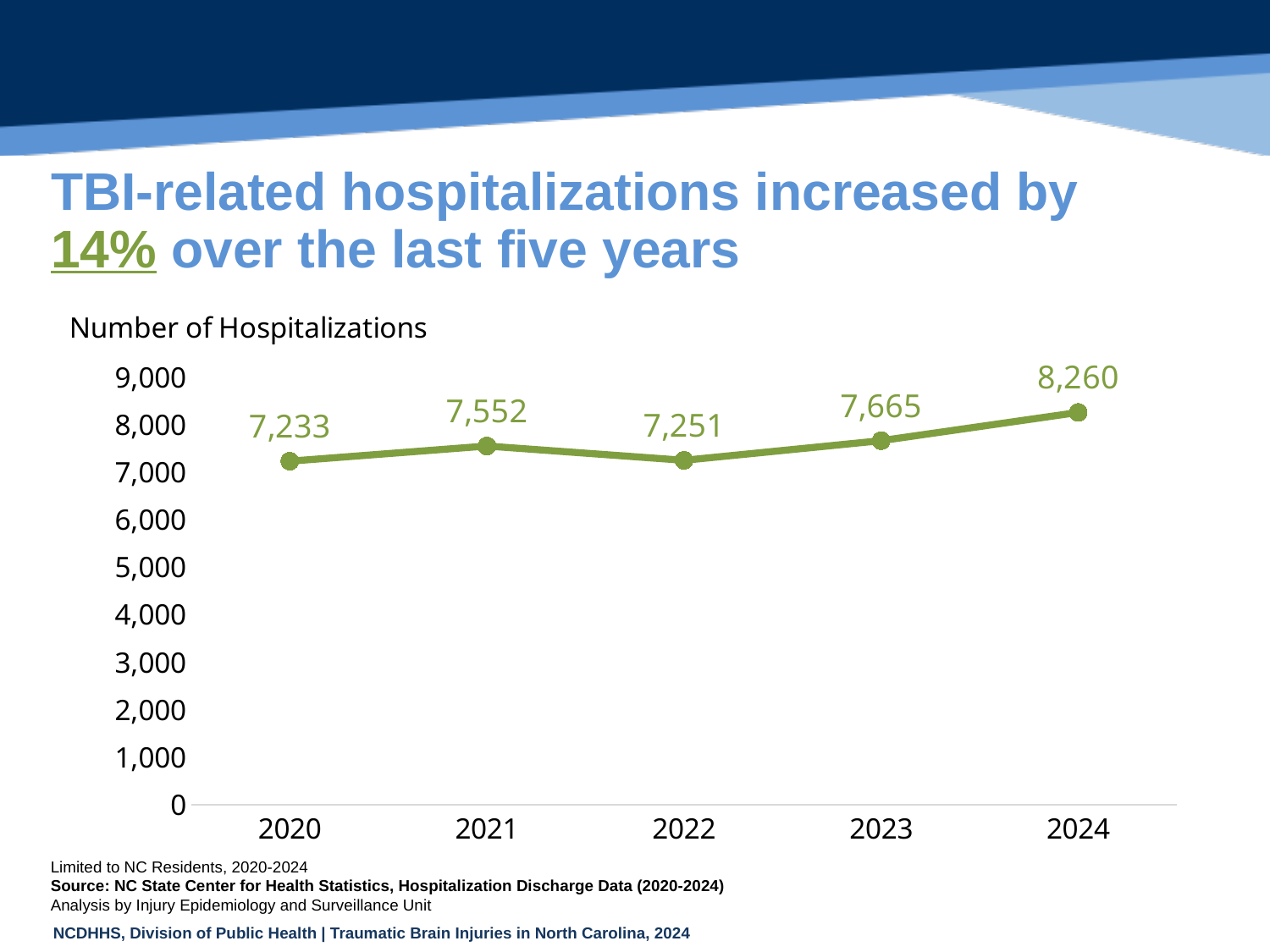
Which year had more hospitalizations, 2021 or 2023? 2023 What kind of chart is shown on the slide? Line chart Which year had the lowest number of hospitalizations? 2020 What is the difference in hospitalizations between 2023 and 2022? 414 What was the number of hospitalizations in 2024? 8,260 What is the difference in hospitalizations between 2024 and 2020? 1,027 Is the value for 2024 greater or less than 8,000? greater What was the number of hospitalizations in 2022? 7,251 How many years are plotted on the chart? 5 Which year had the highest number of hospitalizations? 2024 What was the number of hospitalizations in 2020? 7,233 What is the title of the chart? Number of Hospitalizations